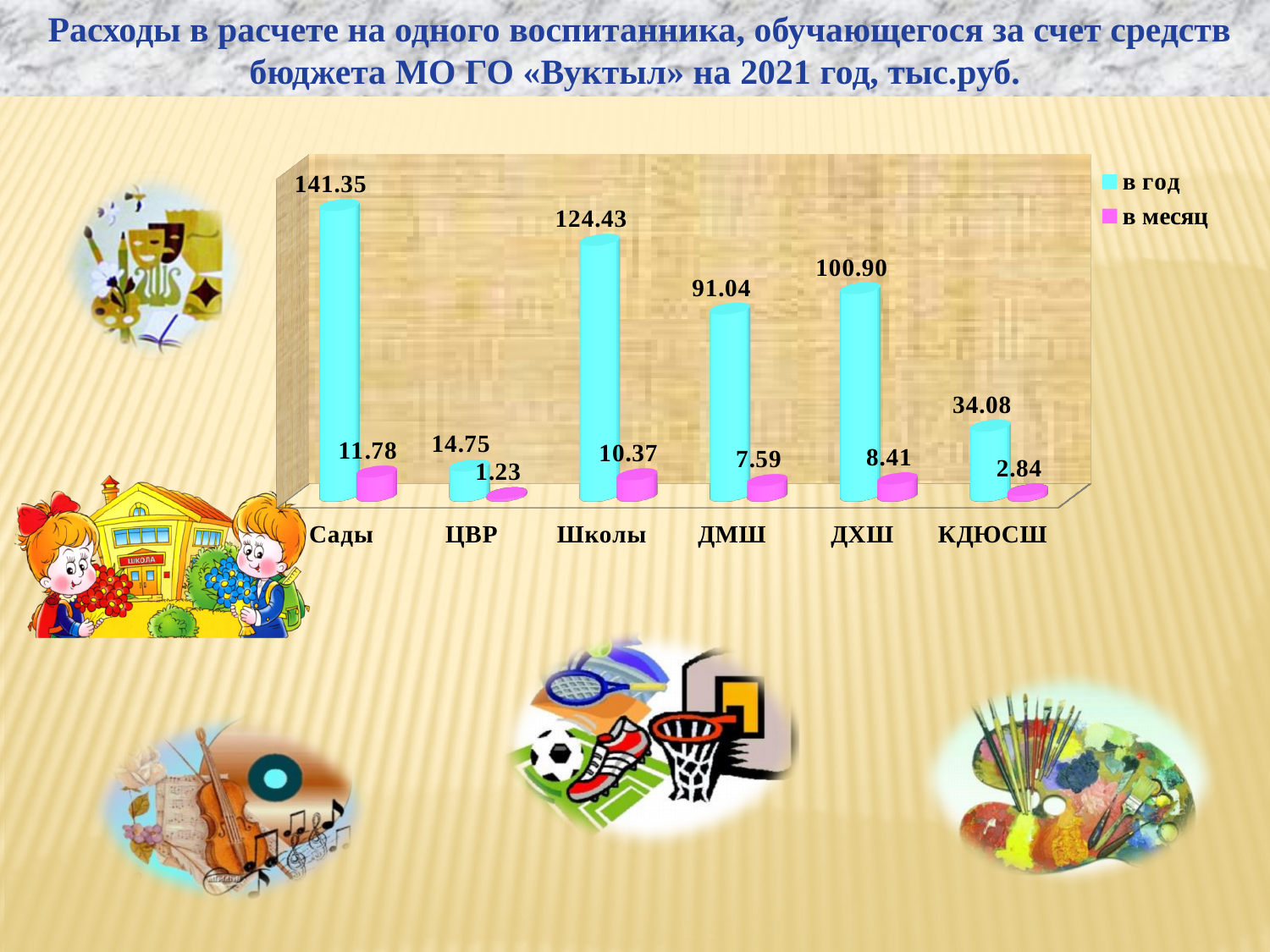
What is the value of "в год" for КДЮСШ? 34.08 How many series does the legend list? 2 What is the value of "в год" for Сады? 141.35 Which category has the lowest "в месяц" value? ЦВР What kind of chart is shown on the slide? Bar chart Which is larger, the "в год" value for ДМШ or for ДХШ? ДХШ What is the value of "в месяц" for Школы? 10.37 What is the difference between the "в год" values for Сады and Школы? 16.92 How many categories are shown on the x axis? 6 Which category has the highest "в год" value? Сады Which series is shown in pink in the legend? в месяц What is the value of "в месяц" for ЦВР? 1.23